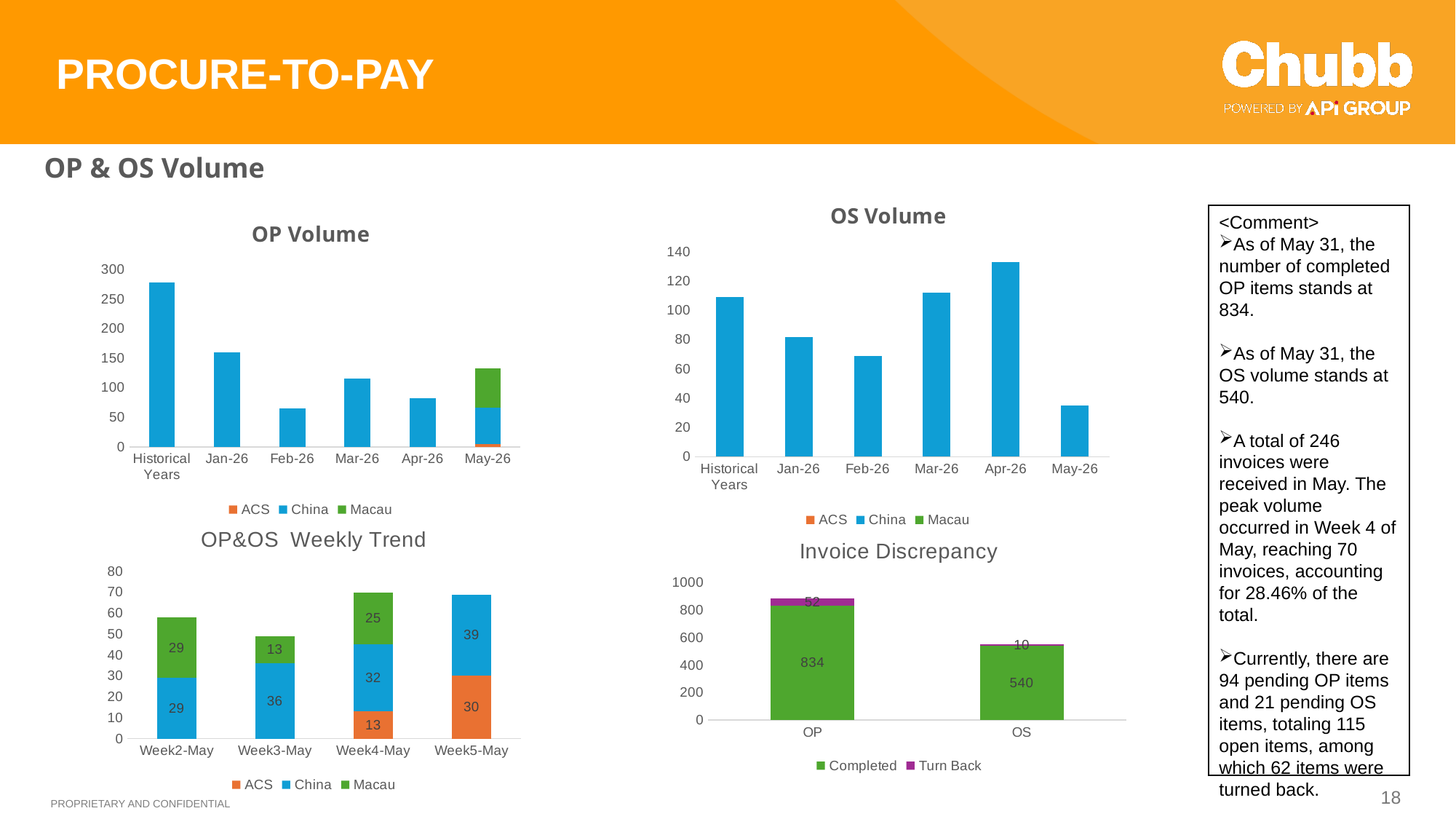
In the OS Volume chart, which category has the lowest bar? May-26 How many series does the legend of the OP&OS Weekly Trend chart list? 3 In the OP Volume chart, is the value for Feb-26 greater or less than 100? less In the Invoice Discrepancy chart, what is the Turn Back value for OS? 10 In the Invoice Discrepancy chart, what is the difference between the Completed values for OP and OS? 294 In the OP&OS Weekly Trend chart, what is the value for China in Week3-May? 36 In the OP Volume chart, which category has the highest bar? Historical Years In the OS Volume chart, which category has the highest bar? Apr-26 In the Invoice Discrepancy chart, what is the Completed value for OP? 834 In the OP&OS Weekly Trend chart, what is the total of the stacked bar for Week4-May? 70 In the OP&OS Weekly Trend chart, what is the value for ACS in Week5-May? 30 What kind of chart is the Invoice Discrepancy chart? bar chart